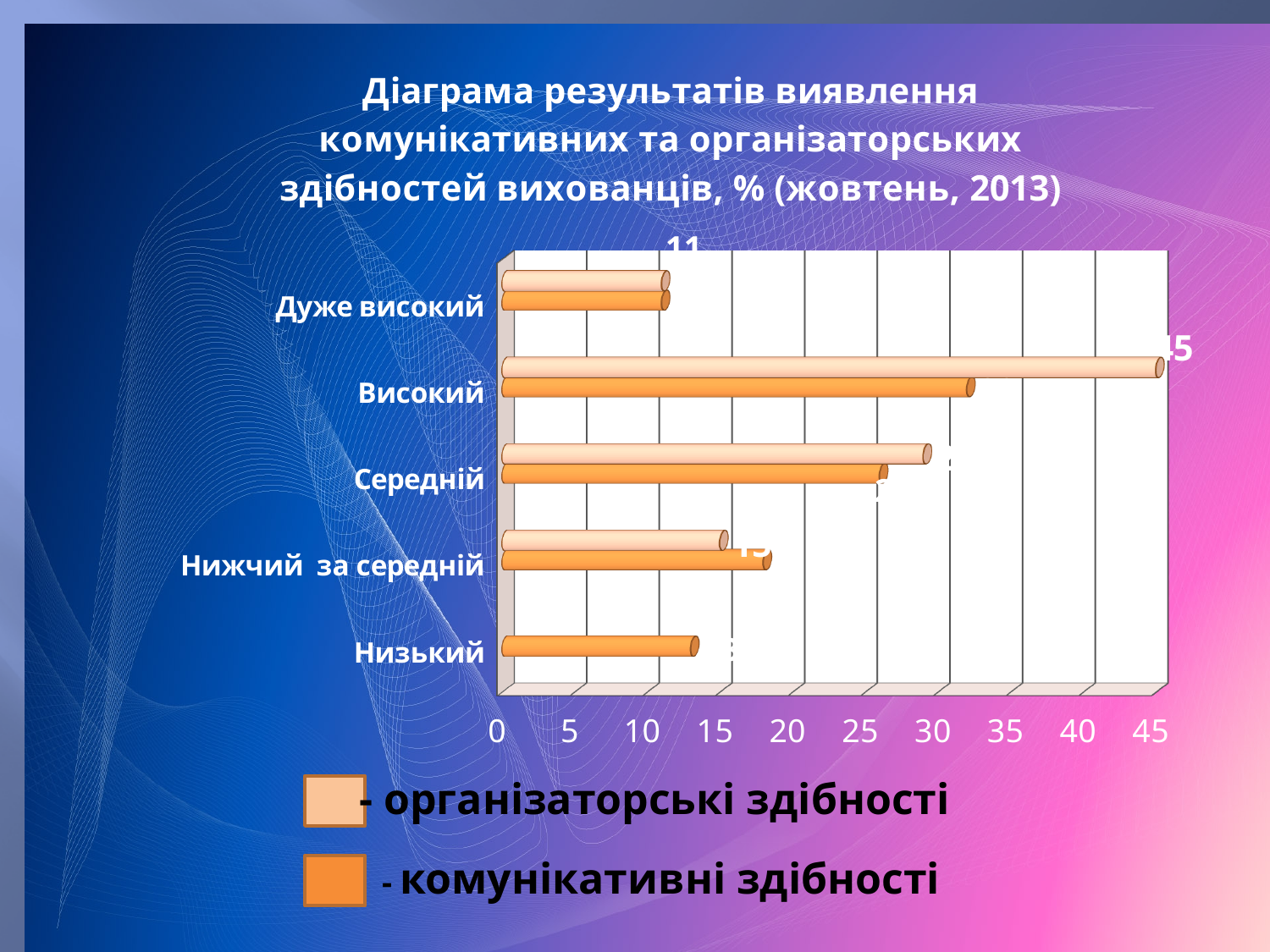
Which category has the highest value for комунікативні здібності? Високий In the Нижчий за середній category, which series has the larger value: організаторські здібності or комунікативні здібності? комунікативні здібності How many categories are shown on the vertical axis of the chart? 5 Is the value for комунікативні здібності in the Високий category greater or less than 30? greater How many series does the legend list? 2 Is the value for комунікативні здібності in the Низький category greater or less than 20? less Is the value for організаторські здібності in the Середній category greater or less than 25? greater What kind of chart is shown on the slide? bar chart Which category has the highest value for організаторські здібності? Високий Which series is shown in the darker orange colour? комунікативні здібності In the Високий category, which series has the larger value: організаторські здібності or комунікативні здібності? організаторські здібності What is the value for організаторські здібності in the Високий category? 45